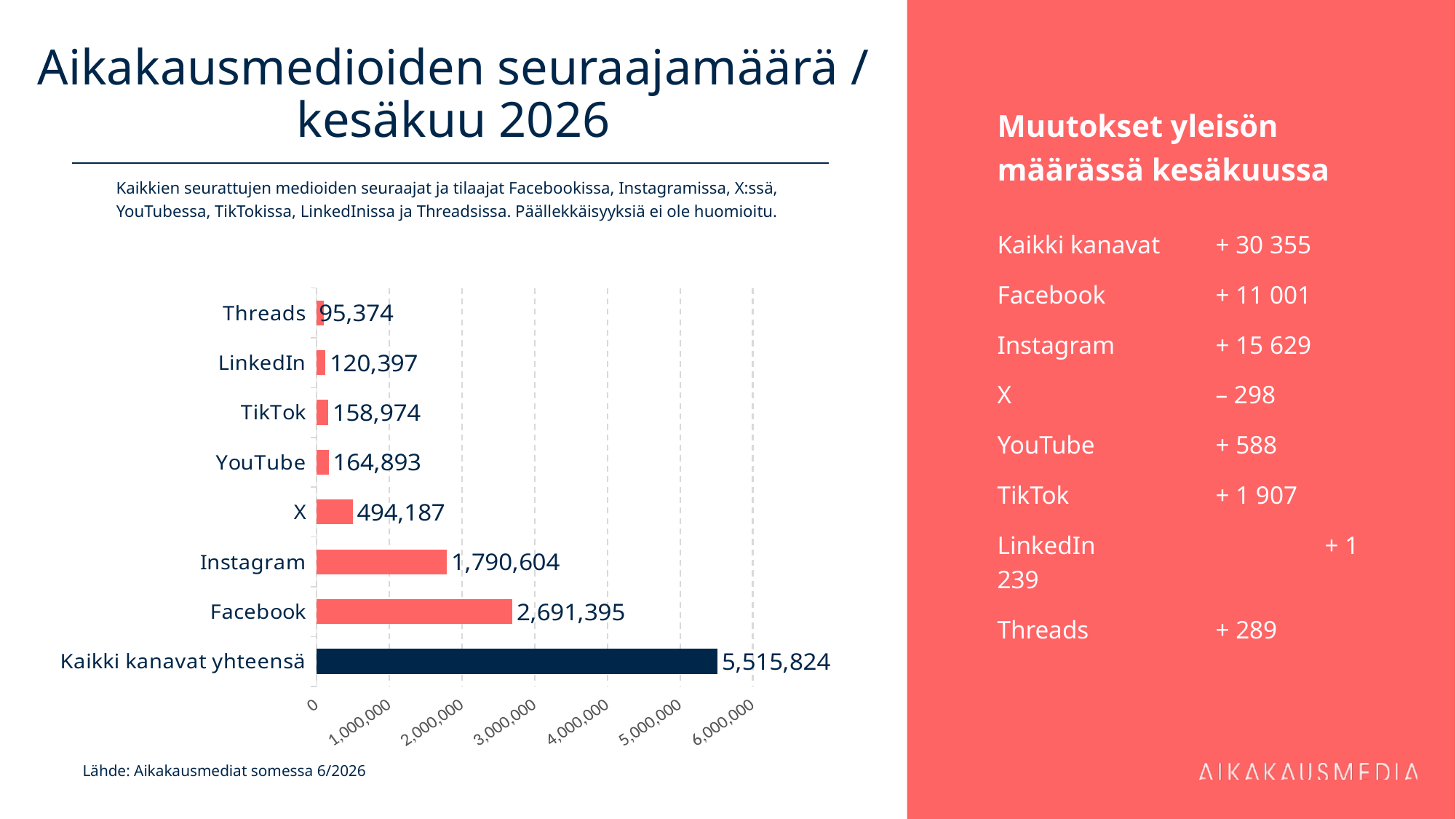
Which category has the lowest value in the bar chart? Threads What is the difference between the X and YouTube values in the bar chart? 329,294 What is the value for Threads in the bar chart? 95,374 What is the difference between the Facebook and Instagram values in the bar chart? 900,791 What is the value for Facebook in the bar chart? 2,691,395 What is the value shown for 'Kaikki kanavat yhteensä' in the bar chart? 5,515,824 Which individual platform (excluding the total bar) has the highest value in the bar chart? Facebook What kind of chart is shown on the slide? Bar chart What is the value for X in the bar chart? 494,187 Which has a larger value in the bar chart, X or TikTok? X What is the value for Instagram in the bar chart? 1,790,604 How many categories are shown in the bar chart? 8